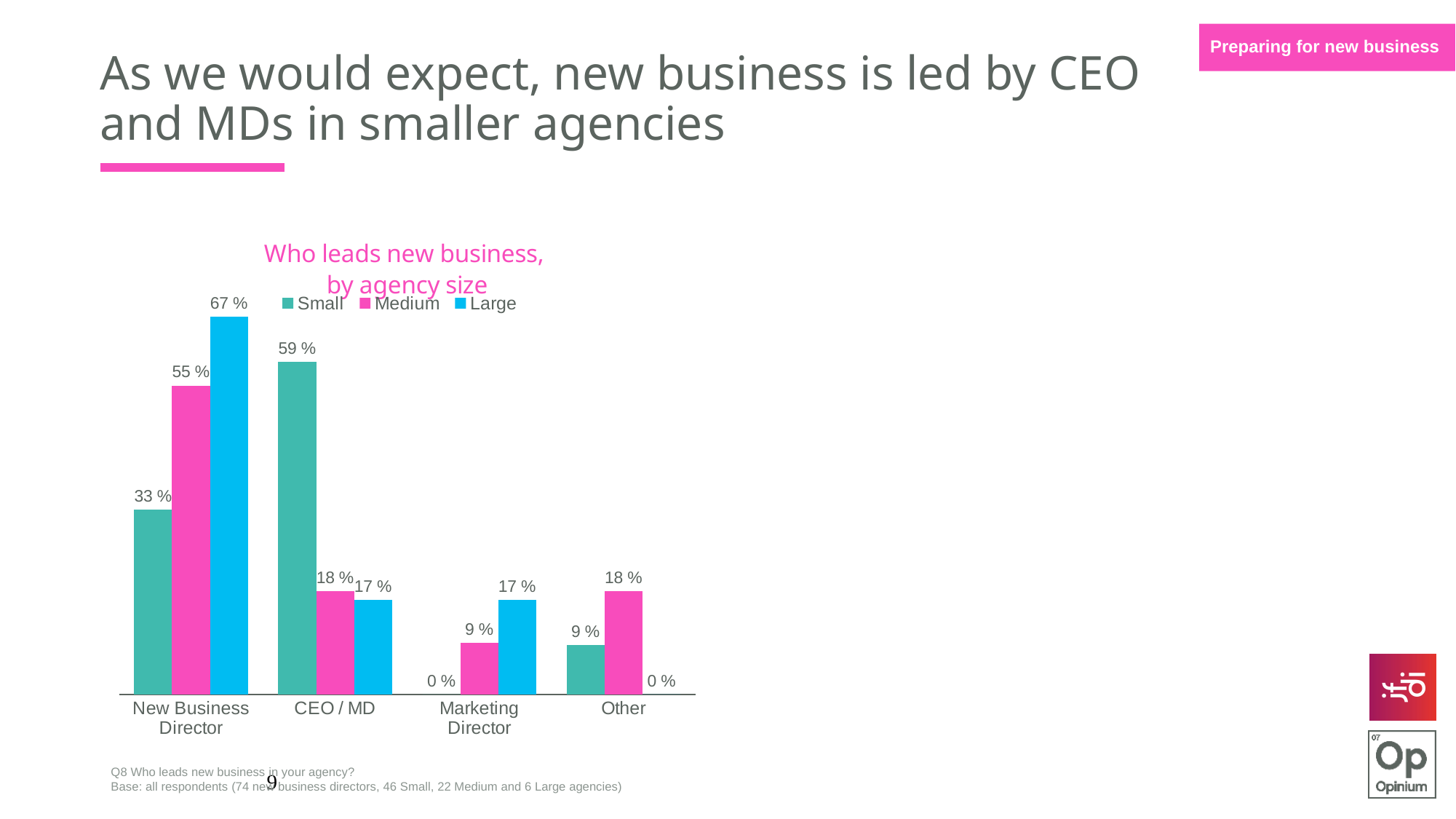
What kind of chart is shown on the slide? Bar chart How many series does the legend list? 3 Which category has the highest value for Small agencies? CEO / MD What is the value for Medium agencies in the Marketing Director category? 9 % Which category has the lowest value for Large agencies? Other What is the value for Large agencies in the Other category? 0 % What is the title of the chart? Who leads new business, by agency size What is the value for Large agencies in the New Business Director category? 67 % In the CEO / MD category, which is larger: the Small value or the Medium value? Small What is the value for Small agencies in the CEO / MD category? 59 % What is the difference between the Large and Small values in the New Business Director category? 34 % How many categories are shown on the x axis? 4